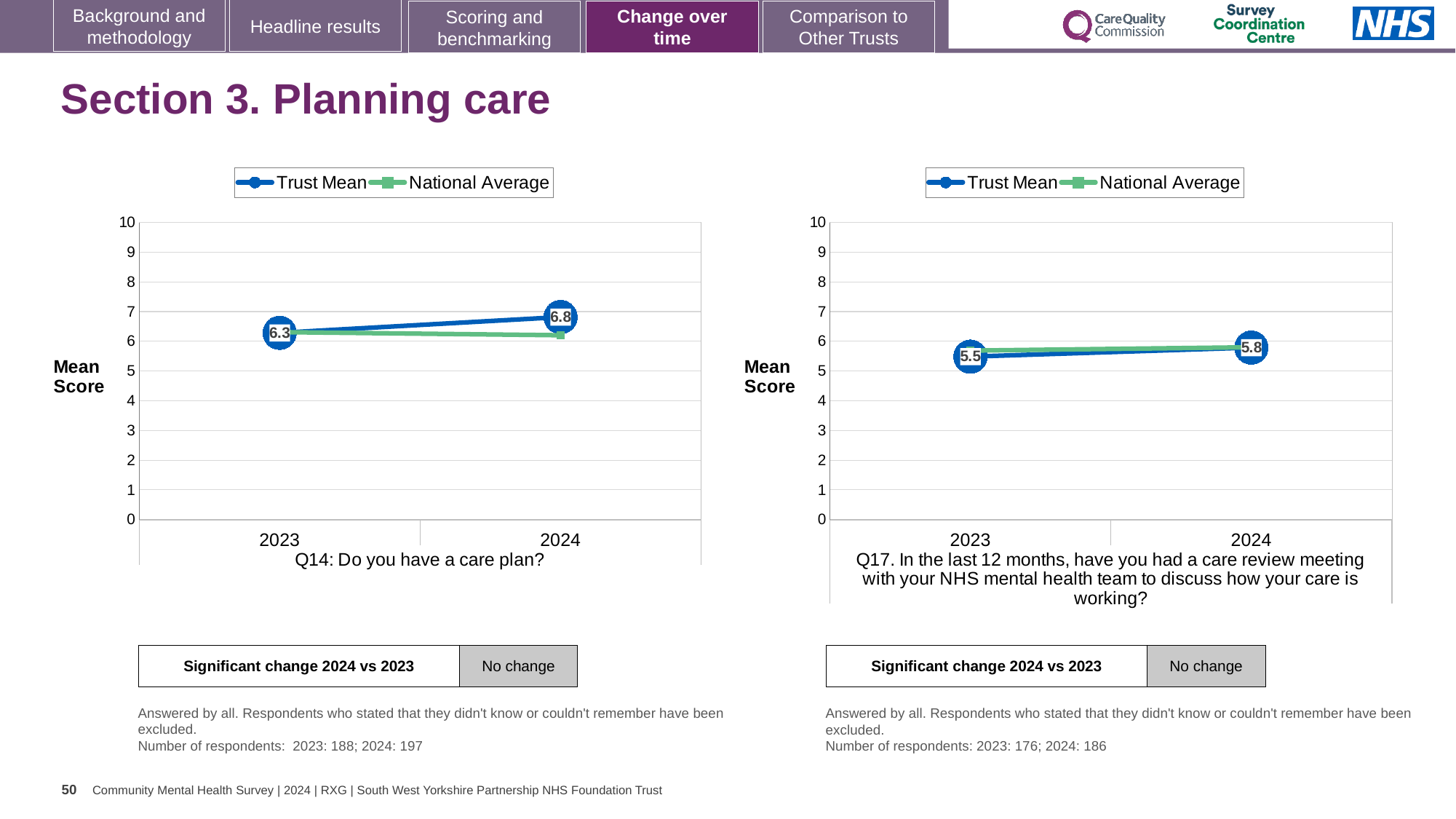
In the Q14 chart on the left, does the Trust Mean rise or fall from 2023 to 2024? rise How many years are plotted on the x axis of the Q17 chart on the right? 2 In the Q17 chart on the right, what is the Trust Mean score for 2024? 5.8 In the Q14 chart on the left, what is the Trust Mean score for 2023? 6.3 In the Q14 chart on the left, is the National Average for 2024 greater or less than 7? less In the Q14 chart on the left, what is the Trust Mean score for 2024? 6.8 Which is larger: the 2024 Trust Mean in the Q14 chart on the left or the 2024 Trust Mean in the Q17 chart on the right? Q14 chart (6.8) In the Q17 chart on the right, what is the Trust Mean score for 2023? 5.5 How many series does the legend of the Q17 chart on the right list? 2 What kind of chart is the Q14 chart on the left? line chart In the Q14 chart on the left, by how much did the Trust Mean change from 2023 to 2024? 0.5 In the Q17 chart on the right, what is the difference between the Trust Mean for 2024 and 2023? 0.3